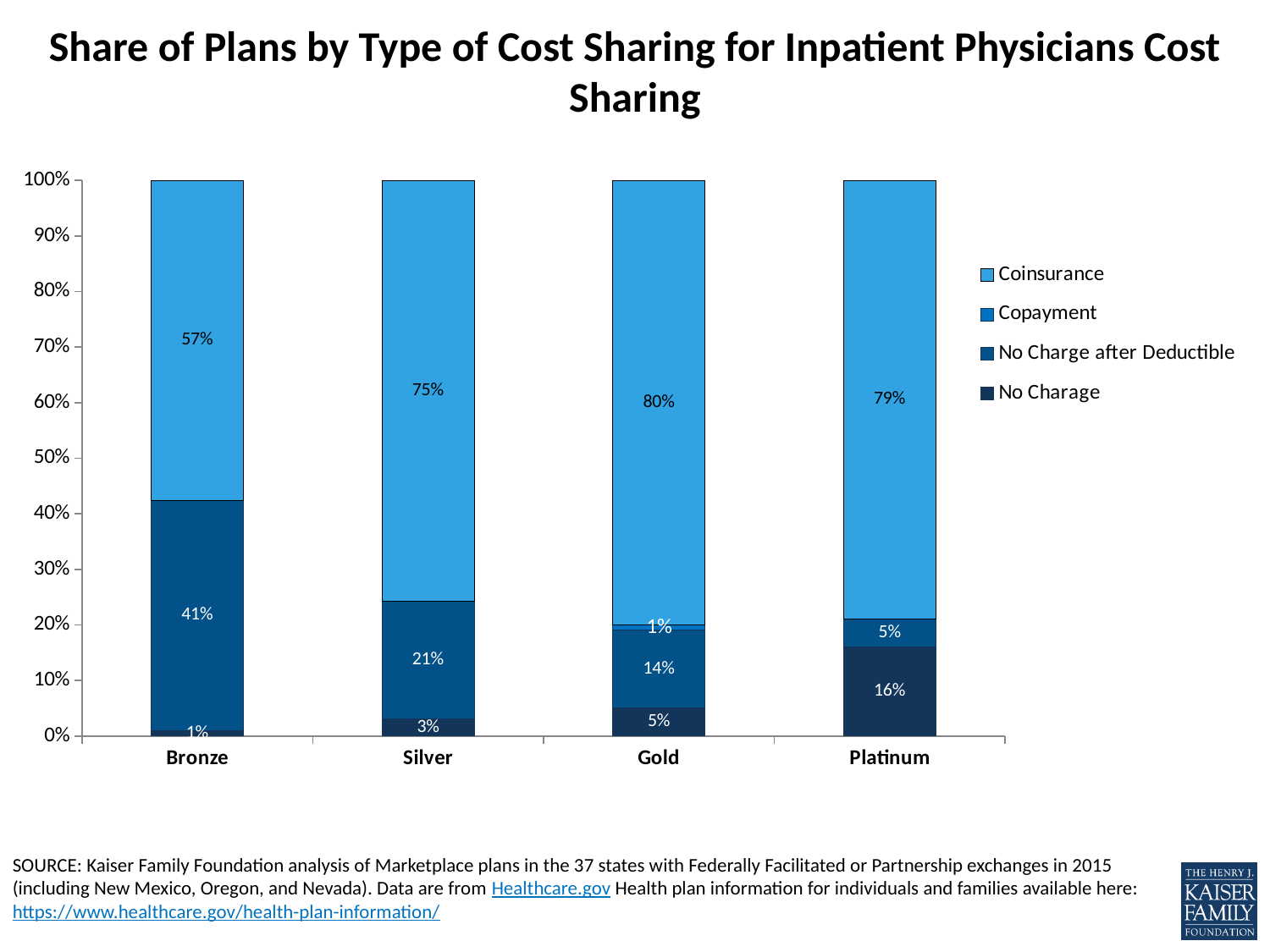
Which plan type has the highest Coinsurance share? Gold Which has a larger No Charge after Deductible share, Bronze or Silver? Bronze What is the No Charge after Deductible share for Gold plans? 14% Which series is listed first in the legend? Coinsurance What is the No Charge share for Platinum plans? 16% How many plan types (categories) are shown on the x axis? 4 How many series does the legend list? 4 Which plan type has the lowest Coinsurance share? Bronze What is the Coinsurance share for Bronze plans? 57% What kind of chart is shown on the slide? Stacked bar chart What is the difference between the Coinsurance share for Silver and for Bronze? 18 percentage points What is the Coinsurance share for Gold plans? 80%